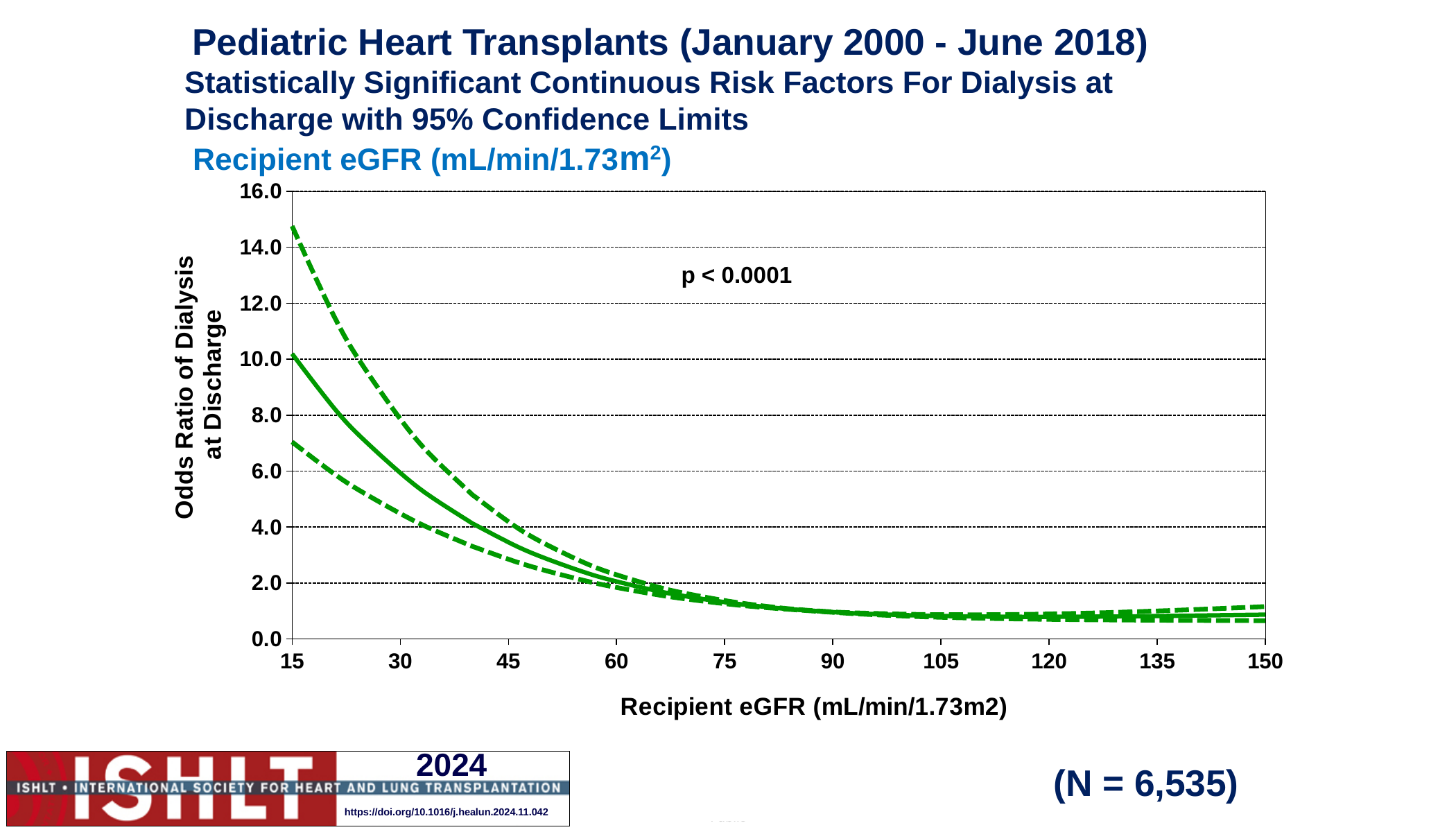
Does the odds ratio of dialysis at discharge rise or fall as recipient eGFR increases from 15 to 90? fall What kind of chart is shown on the slide? line chart Is the value of the upper dashed line at a recipient eGFR of 150 greater or less than 2.0? less Is the value of the upper dashed line at a recipient eGFR of 15 greater or less than 12.0? greater What is the label of the y axis? Odds Ratio of Dialysis at Discharge At which recipient eGFR value on the x axis is the solid line highest? 15 Is the value of the lower dashed line at a recipient eGFR of 15 greater or less than 8.0? less What p-value is printed on the chart? p < 0.0001 How many lines are plotted on the chart? 3